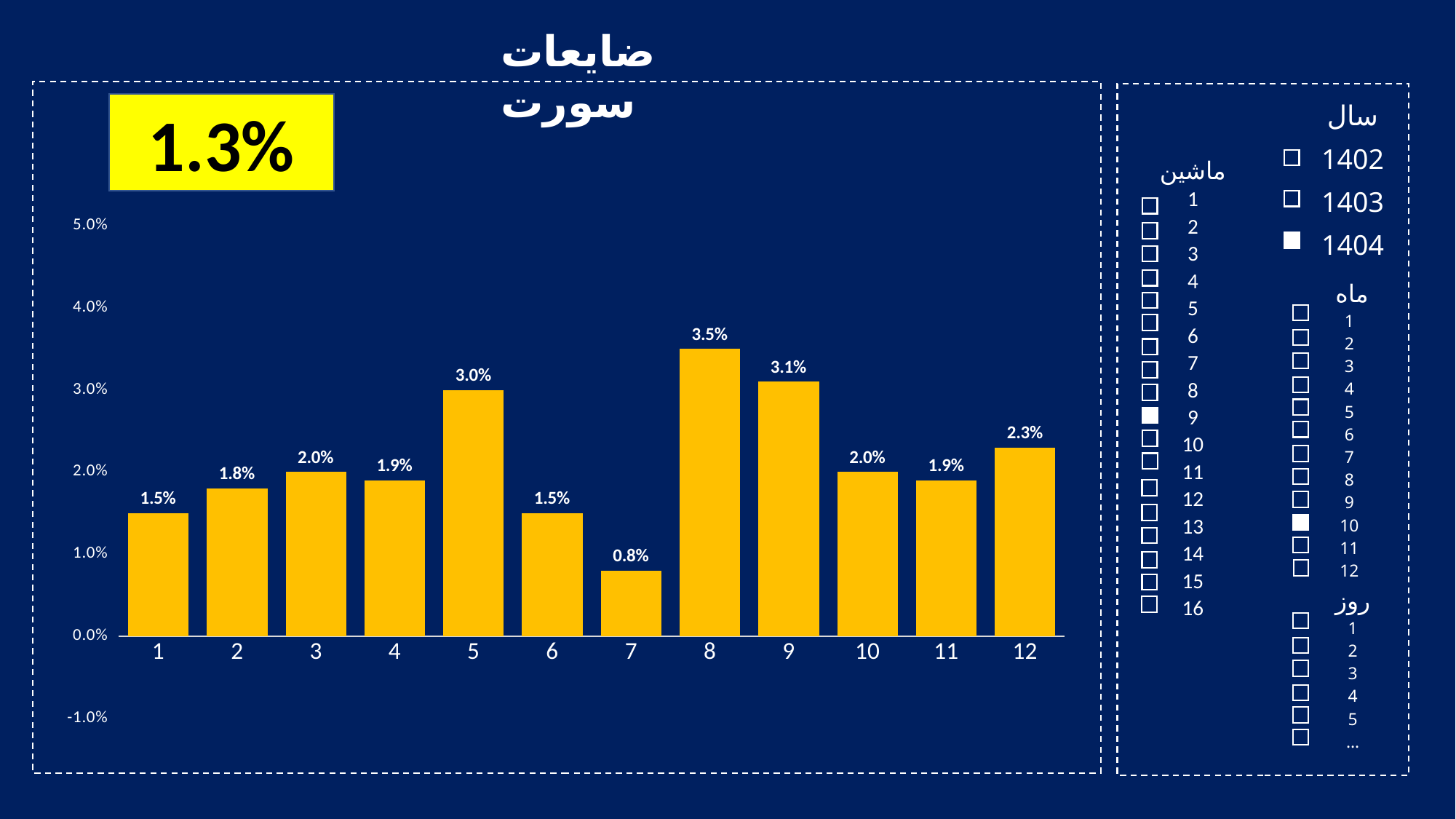
What kind of chart is shown? bar chart What is the value for category 7? 0.8% What value is shown in the yellow box at the top left of the chart? 1.3% What is the difference between the values for category 5 and category 6? 1.5% Which is larger, the value for category 9 or the value for category 5? 9 Which category has the lowest value? 7 Which category has the highest value? 8 What is the value for category 8? 3.5% Is the value for category 12 greater or less than 2.0%? greater What is the difference between the values for category 8 and category 7? 2.7% How many categories are shown on the x axis? 12 What is the value for category 12? 2.3%